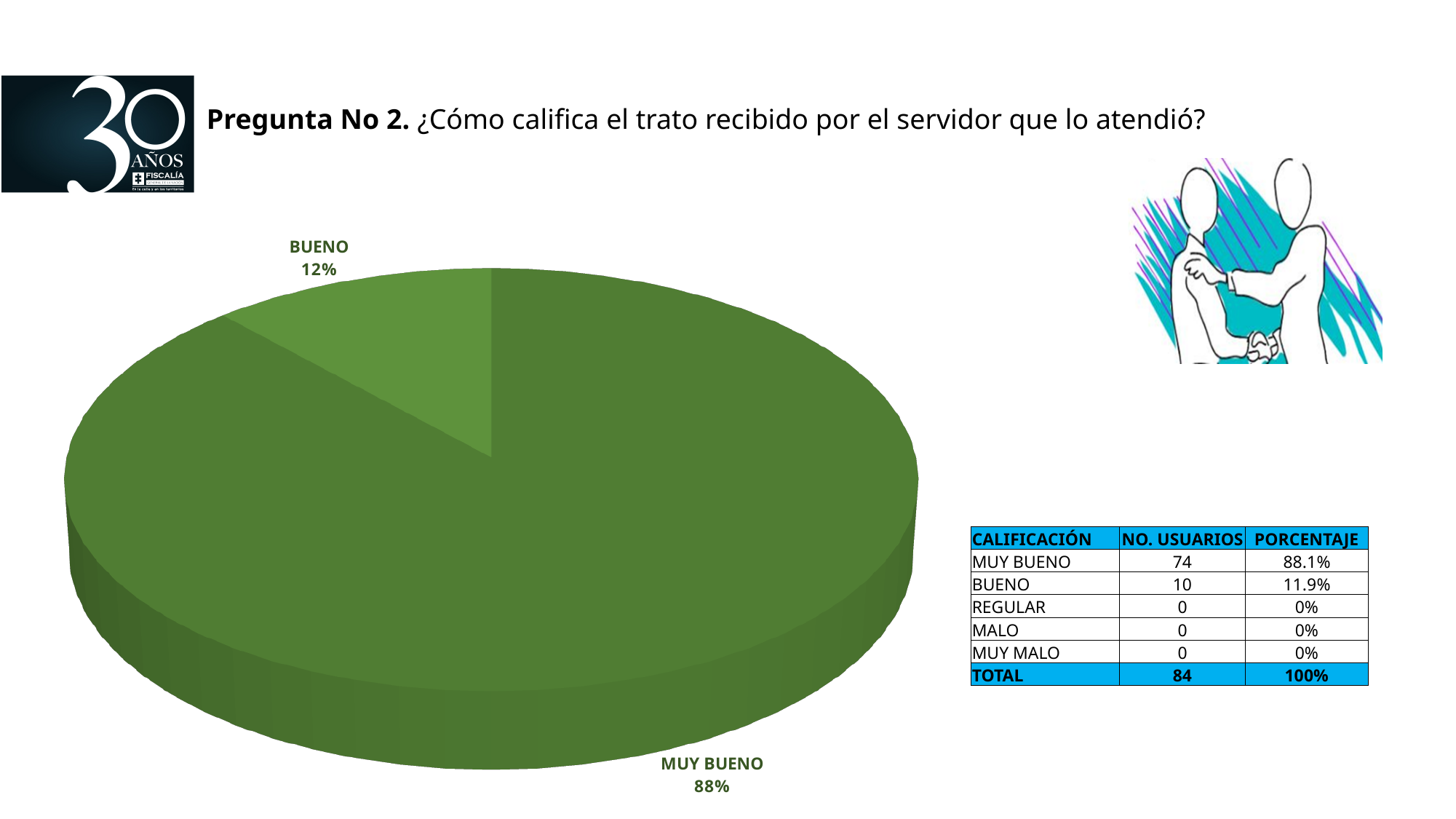
Which slice is larger in the pie chart, MUY BUENO or BUENO? MUY BUENO What percentage does the MUY BUENO slice show in the pie chart? 88% What is the difference in percentage points between the MUY BUENO and BUENO slices in the pie chart? 76 Which category has the largest slice in the pie chart? MUY BUENO Is the share of the MUY BUENO slice greater or less than 50%? greater Is the share of the BUENO slice greater or less than 25%? less What is the combined percentage of the two labelled slices in the pie chart? 100% What colour are the slices of the pie chart? Green What kind of chart is shown on the slide? Pie chart How many slices are labelled in the pie chart? 2 Which category has the smallest slice in the pie chart? BUENO What percentage does the BUENO slice show in the pie chart? 12%